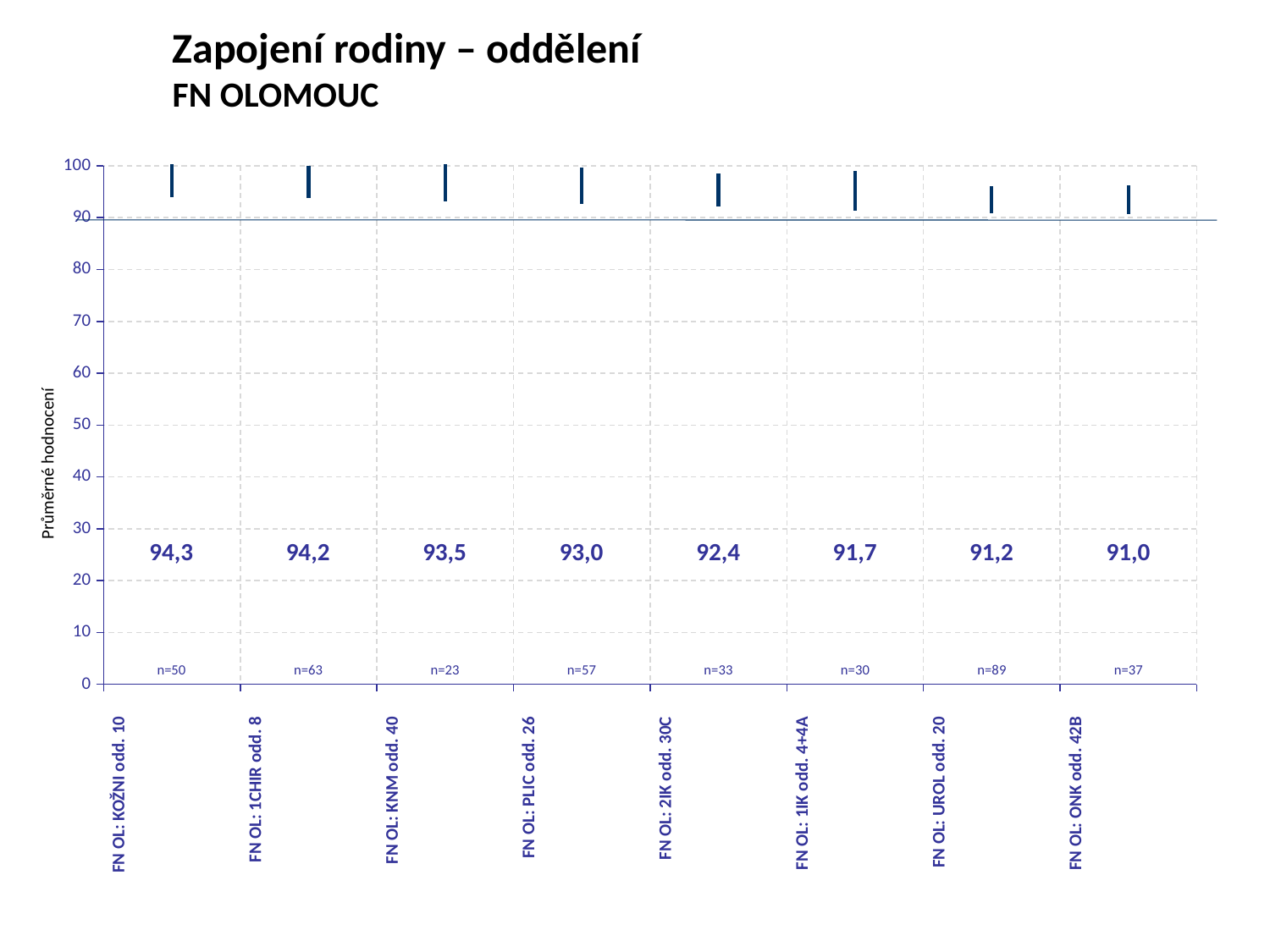
What is the title of the chart? Zapojení rodiny – oddělení FN OLOMOUC How many departments are shown on the chart? 8 What is the average rating for FN OL: PLIC odd. 26? 93,0 Which department has the lowest average rating? FN OL: ONK odd. 42B What is the average rating (průměrné hodnocení) for FN OL: KOŽNI odd. 10? 94,3 What is the difference between the average ratings of FN OL: KOŽNI odd. 10 and FN OL: ONK odd. 42B? 3,3 What is the average rating for FN OL: UROL odd. 20? 91,2 Which has a higher average rating, FN OL: KNM odd. 40 or FN OL: 2IK odd. 30C? FN OL: KNM odd. 40 What is the label of the vertical axis? Průměrné hodnocení Do the average ratings rise or fall from left to right along the x axis? fall What is the sample size (n) shown for FN OL: UROL odd. 20? n=89 Which department has the highest average rating? FN OL: KOŽNI odd. 10